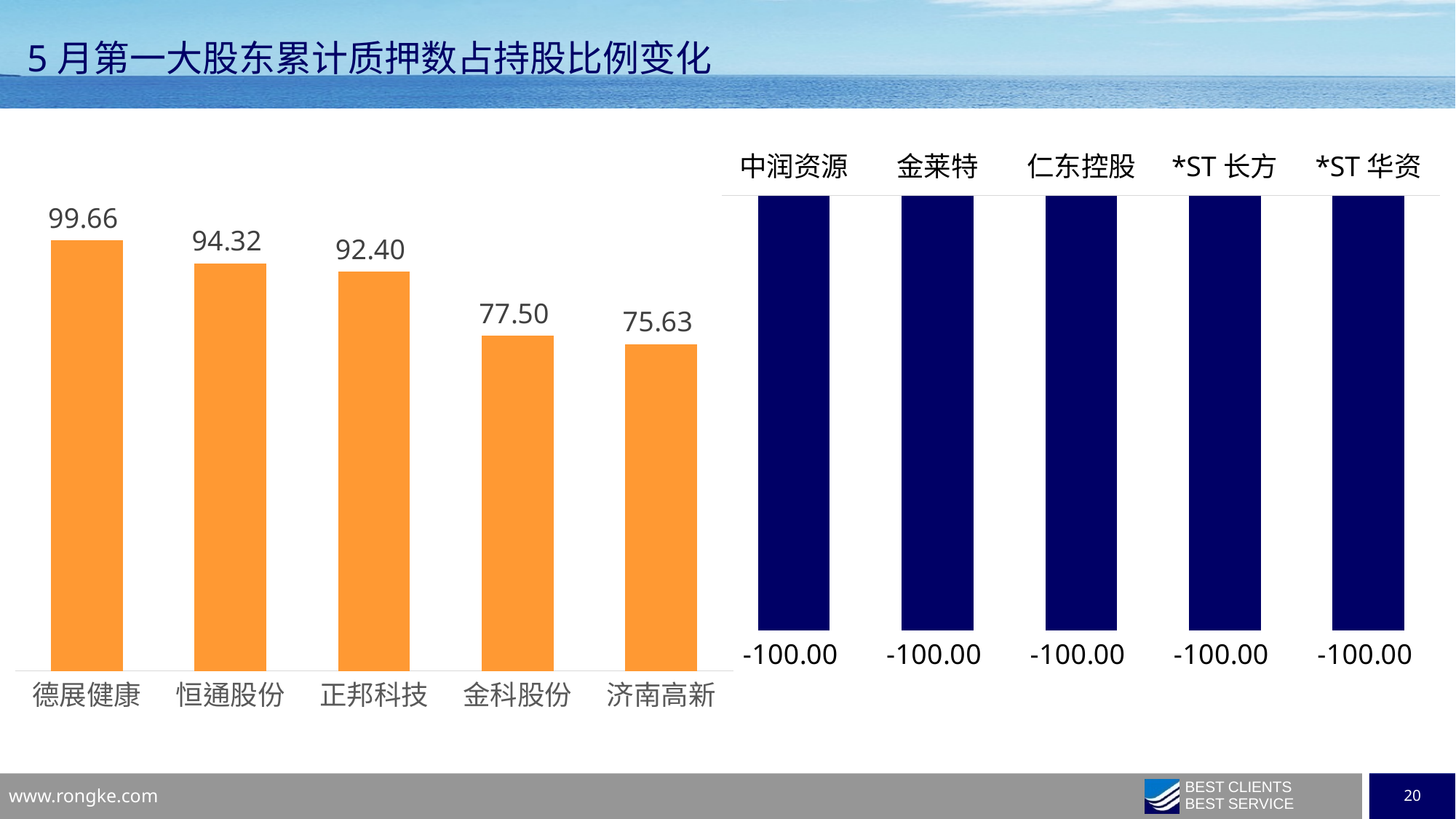
In the left chart, what is the value for 金科股份? 77.50 In the right chart, what is the value for *ST 华资? -100.00 In the left chart, which category has the highest value? 德展健康 What type of chart is the left chart? Bar chart In the left chart, which category has the lowest value? 济南高新 In the right chart, what is the value for 仁东控股? -100.00 In the right chart, how many categories are shown? 5 In the left chart, what is the difference between the values for 德展健康 and 恒通股份? 5.34 In the left chart, how many categories are shown? 5 In the left chart, which is larger, the value for 正邦科技 or the value for 金科股份? 正邦科技 In the left chart, what is the value for 济南高新? 75.63 In the left chart, what is the value for 德展健康? 99.66